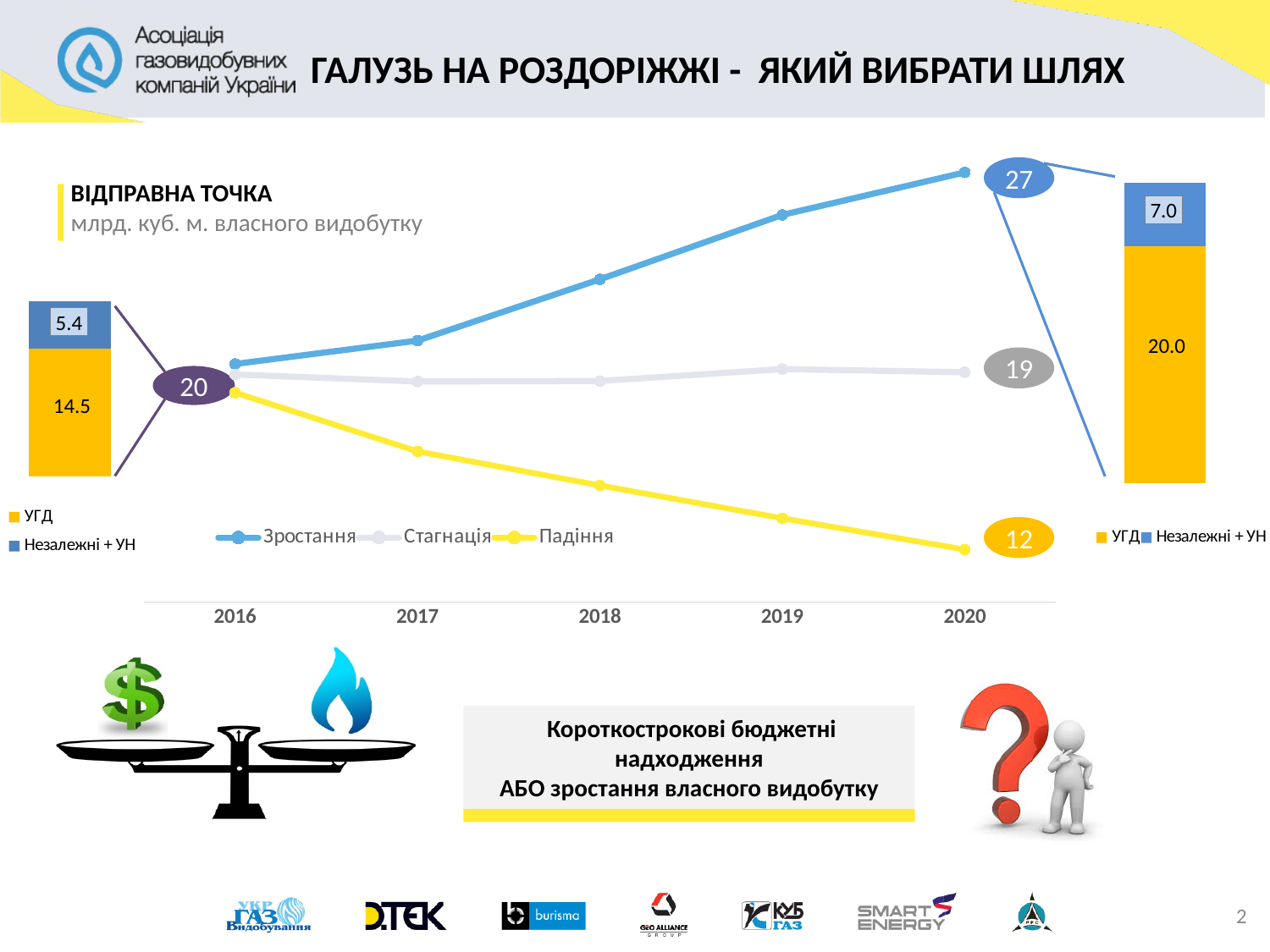
In the stacked bar on the left of the slide, what is the value for УГД? 14.5 In the line chart, which series has the lowest value in 2020? Падіння In the line chart, what is the common starting value of all three series in 2016? 20 In the line chart, what is the value of the Стагнація series in 2020? 19 In the line chart, which series has the highest value in 2020? Зростання In the line chart, what is the value of the Падіння series in 2020? 12 In the line chart, what is the difference between the Зростання and Падіння values in 2020? 15 In the stacked bar on the right of the slide, what is the total of the УГД and Незалежні + УН segments? 27.0 In the line chart, how many series does the legend list? 3 In the line chart, does the Падіння series rise or fall from 2016 to 2020? fall In the line chart, how many years are shown on the x axis? 5 In the line chart, what is the value of the Зростання series in 2020? 27